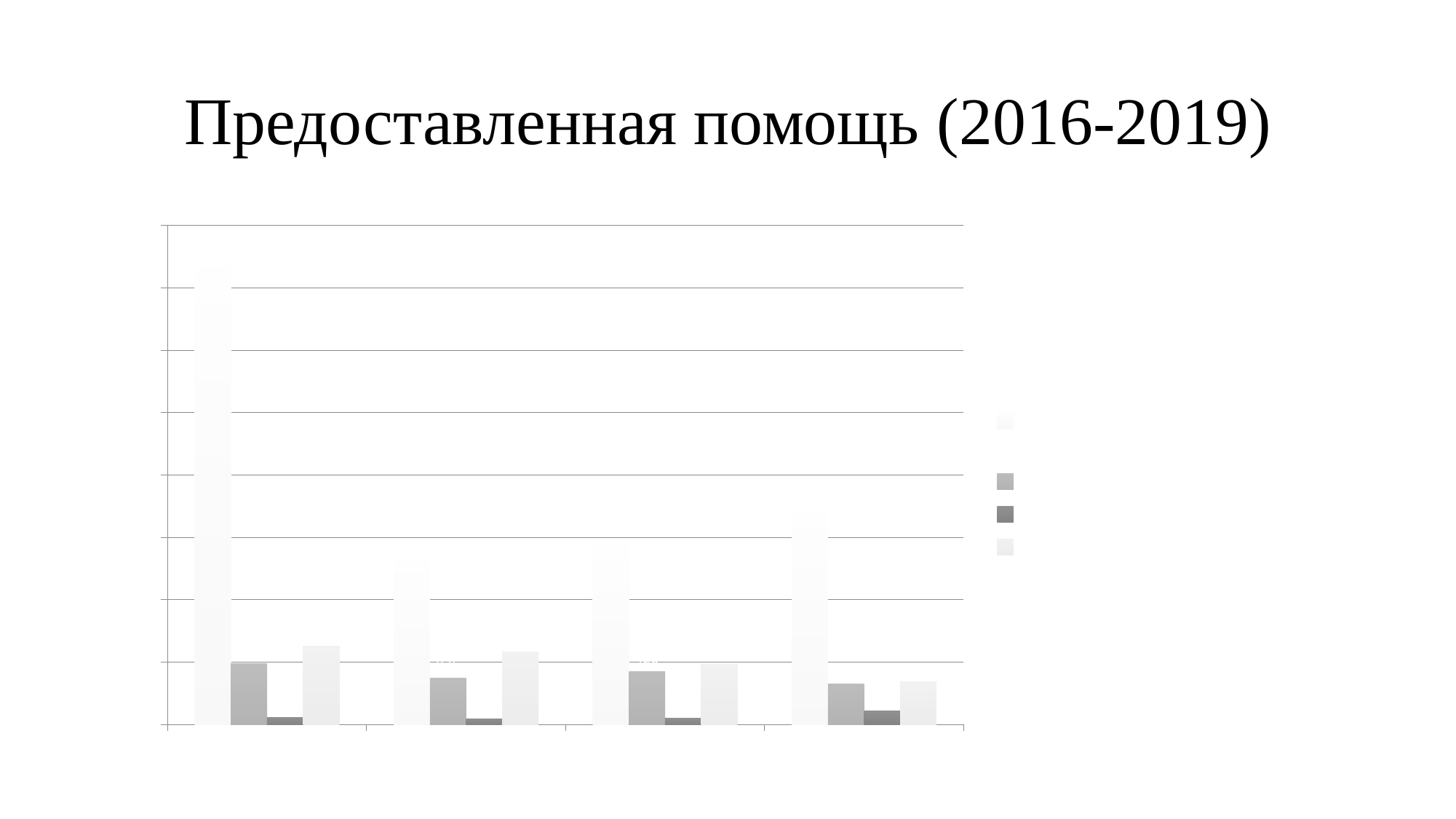
How many bars are in each group? 4 Is the tallest bar in the first group taller than the tallest bar in the fourth group? yes Within each group, which bar (by position) is the shortest? the third bar How many series does the legend list? 4 What is the title of the slide containing the chart? Предоставленная помощь (2016-2019) How many groups of bars are plotted along the x axis? 4 Counting from the left, which group of bars contains the tallest bar on the chart? the first group What kind of chart is shown on the slide? bar chart